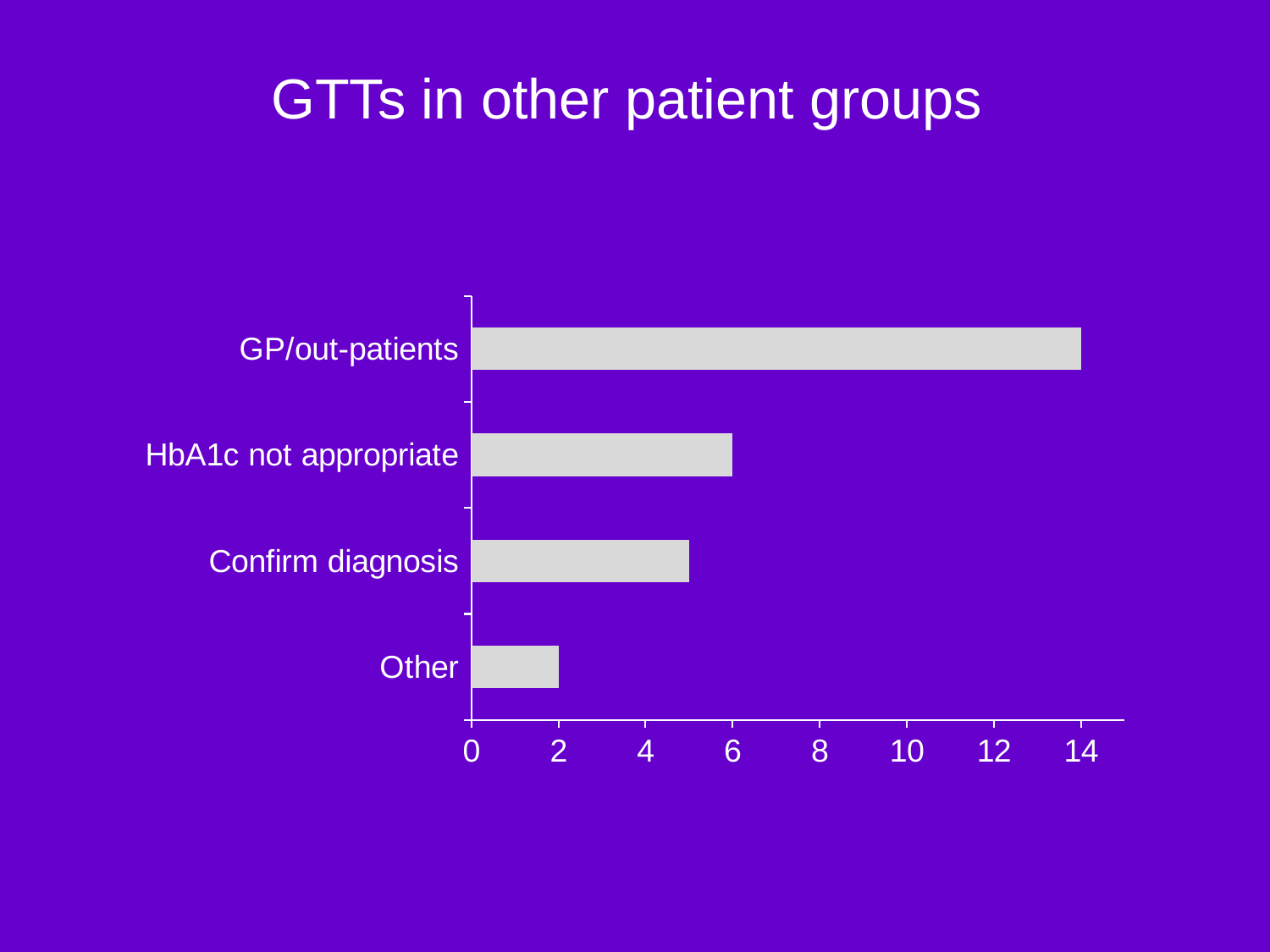
What kind of chart is shown on the slide? bar chart Which is larger, the value for HbA1c not appropriate or the value for Confirm diagnosis? HbA1c not appropriate Is the value for Confirm diagnosis greater or less than 6? less Which category has the highest value? GP/out-patients What is the value for GP/out-patients? 14 Which category has the lowest value? Other What is the value for HbA1c not appropriate? 6 What is the value for Other? 2 Is the value for Confirm diagnosis greater or less than 4? greater What is the title of the chart? GTTs in other patient groups How many categories are shown in the chart? 4 What is the difference between the values for GP/out-patients and HbA1c not appropriate? 8